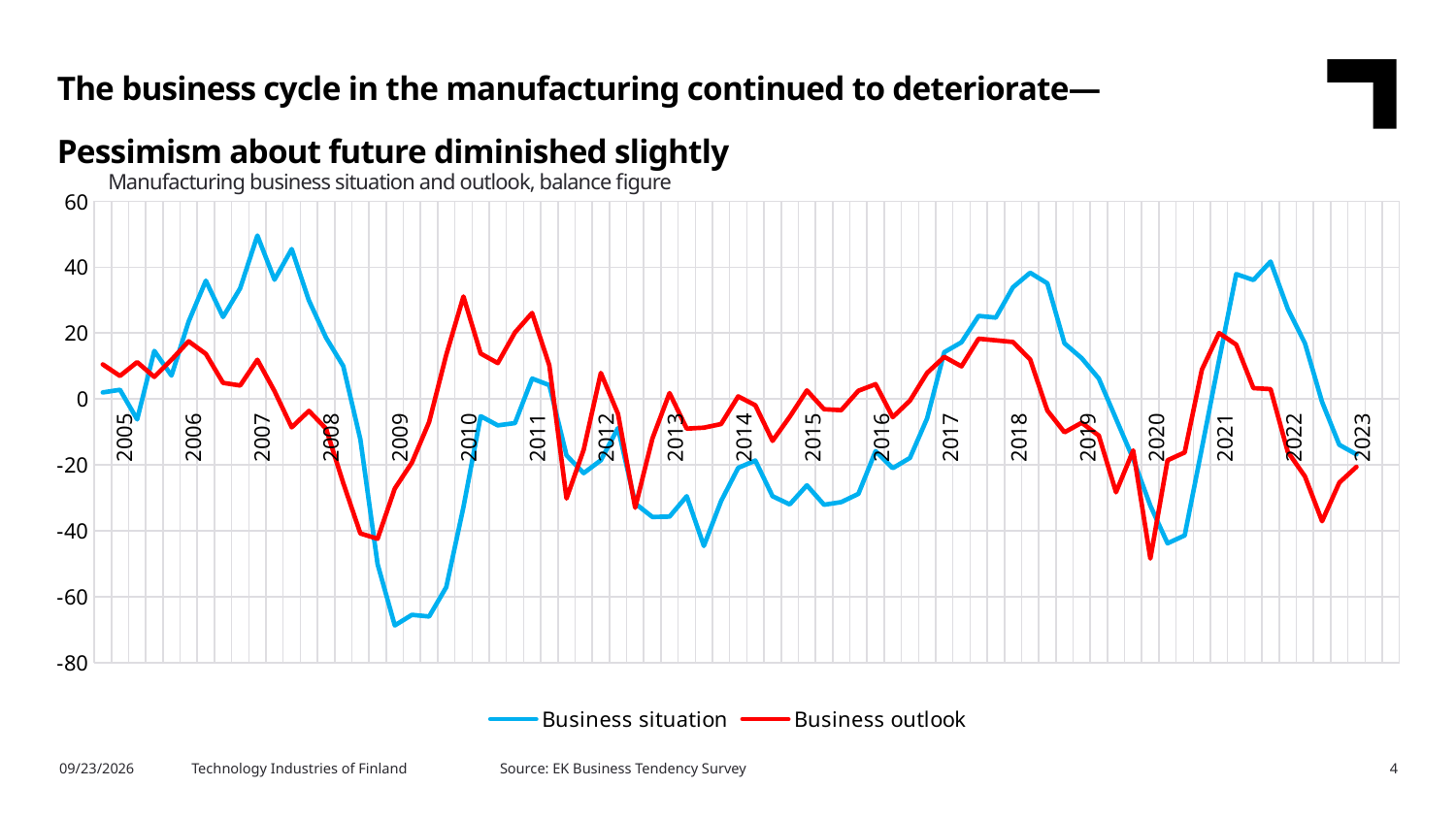
What is the chart's subtitle above the plot area? Manufacturing business situation and outlook, balance figure How many year labels are shown on the x axis? 19 Around 2009, which series has the lower value, Business situation or Business outlook? Business situation What are the two series named in the legend? Business situation and Business outlook What kind of chart is shown on the slide? line chart Is the highest value of the Business situation line, reached around 2007, greater or less than 40? greater How many series does the legend list? 2 Around 2018, which series has the higher value, Business situation or Business outlook? Business situation Is the lowest value of the Business situation line, reached around 2009, greater or less than -60? less Is the lowest value of the Business outlook line, reached around 2020, greater or less than -40? less